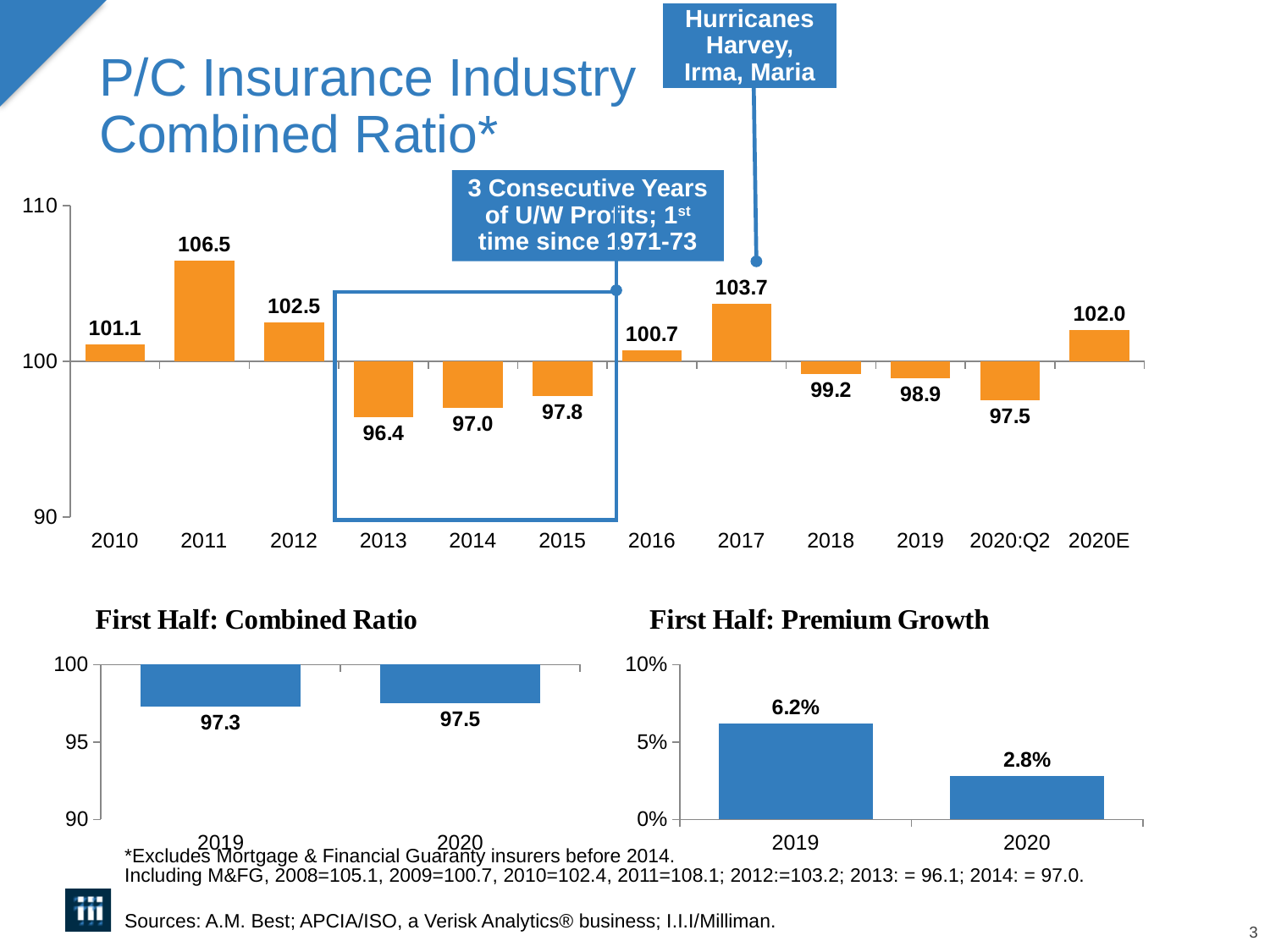
In the P/C Insurance Industry Combined Ratio chart, which is larger, the value for 2016 or the value for 2018? 2016 In the P/C Insurance Industry Combined Ratio chart, what is the difference between the 2011 and 2013 values? 10.1 In the P/C Insurance Industry Combined Ratio chart, how many categories are shown on the x axis? 12 In the P/C Insurance Industry Combined Ratio chart, what is the combined ratio for 2011? 106.5 In the First Half: Combined Ratio chart, what is the value for 2019? 97.3 In the P/C Insurance Industry Combined Ratio chart, which year has the highest combined ratio? 2011 In the P/C Insurance Industry Combined Ratio chart, which year has the lowest combined ratio? 2013 What kind of chart is the P/C Insurance Industry Combined Ratio chart? bar chart In the First Half: Premium Growth chart, do the values rise or fall from 2019 to 2020? fall In the P/C Insurance Industry Combined Ratio chart, what is the value for 2017? 103.7 In the First Half: Premium Growth chart, what is the value for 2020? 2.8% In the First Half: Premium Growth chart, what is the difference between the 2019 and 2020 values? 3.4%